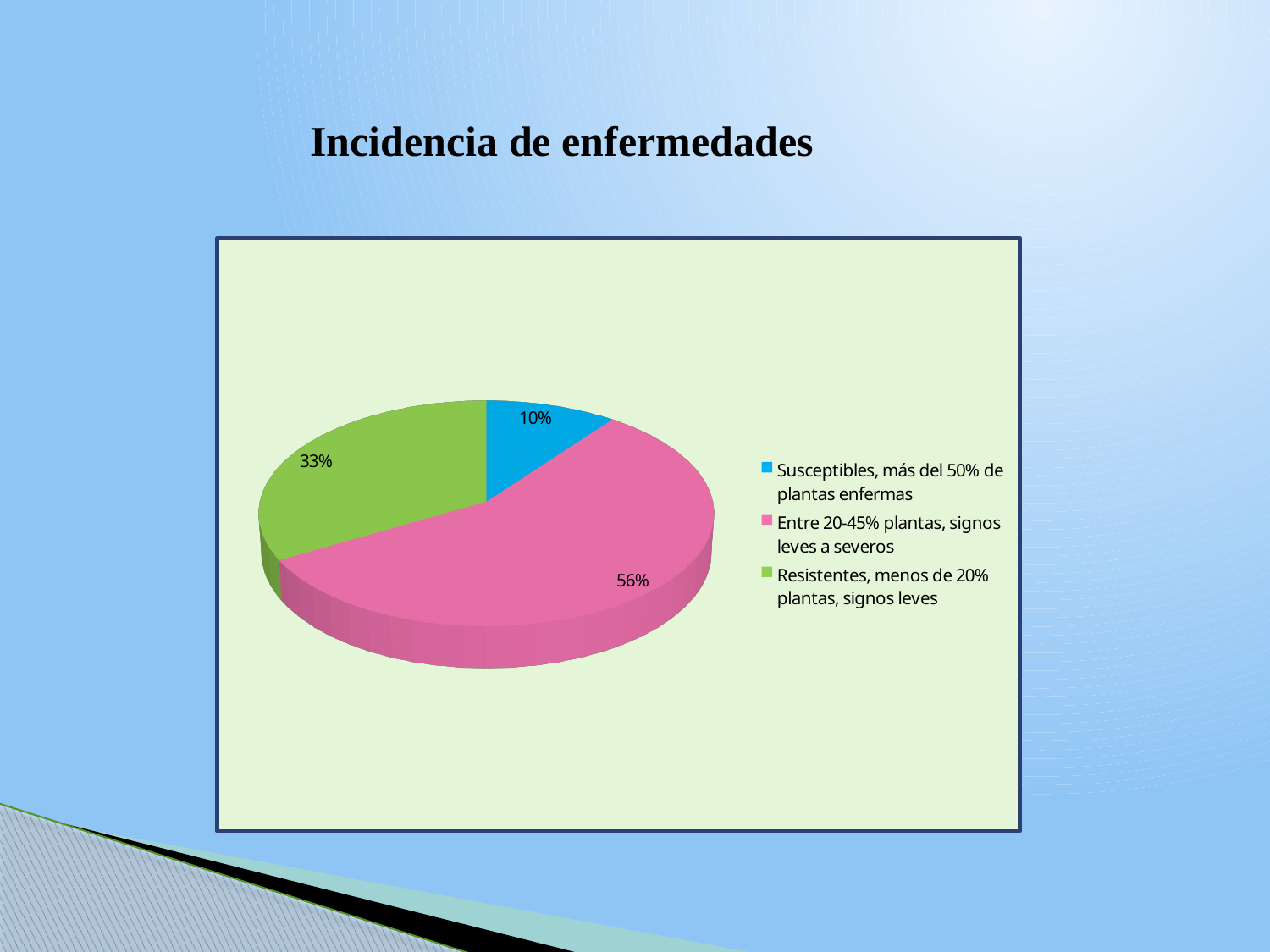
What is the title of the slide above the chart? Incidencia de enfermedades What is the difference in percentage points between the 'Entre 20-45% plantas, signos leves a severos' slice and the 'Resistentes, menos de 20% plantas, signos leves' slice? 23 How many entries does the legend list? 3 Which category has the largest slice of the pie? Entre 20-45% plantas, signos leves a severos What share of the pie is labelled 'Susceptibles, más del 50% de plantas enfermas'? 10% What kind of chart is shown on the slide? pie chart How many slices does the pie chart have? 3 What colour is the slice for 'Susceptibles, más del 50% de plantas enfermas'? blue Which category has the smallest slice of the pie? Susceptibles, más del 50% de plantas enfermas What share of the pie is labelled 'Entre 20-45% plantas, signos leves a severos'? 56% What share of the pie is labelled 'Resistentes, menos de 20% plantas, signos leves'? 33% Which is larger: the 'Resistentes, menos de 20% plantas, signos leves' slice or the 'Susceptibles, más del 50% de plantas enfermas' slice? Resistentes, menos de 20% plantas, signos leves